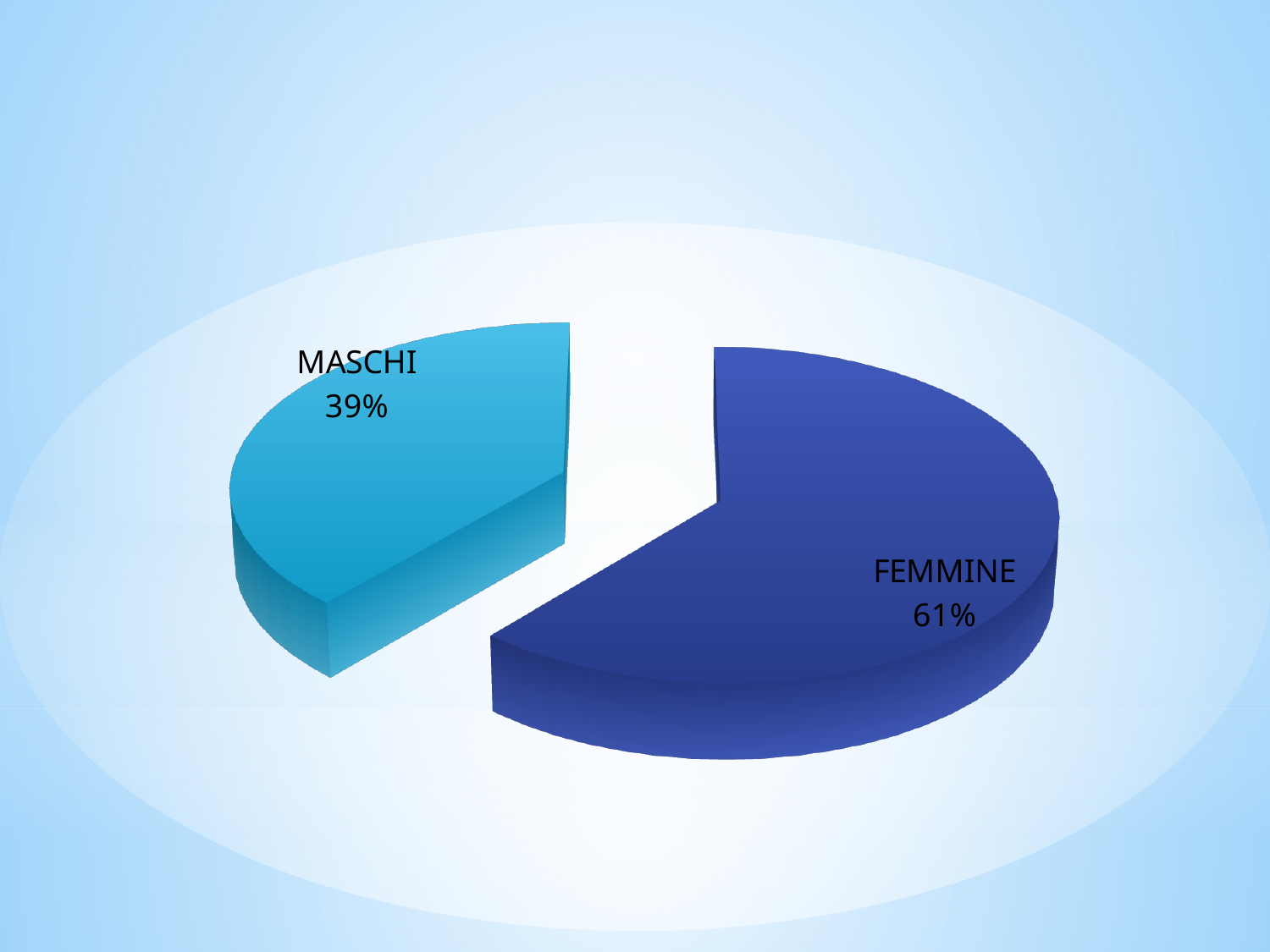
How many slices does the pie chart have? 2 What share of the pie does MASCHI represent? 39% What is the difference in percentage points between FEMMINE and MASCHI? 22 Which is larger, MASCHI or FEMMINE? FEMMINE What kind of chart is shown on the slide? pie chart Which slice is the largest? FEMMINE What share of the pie does FEMMINE represent? 61% What colour is the MASCHI slice? light blue What colour is the FEMMINE slice? dark blue Which slice is the smallest? MASCHI